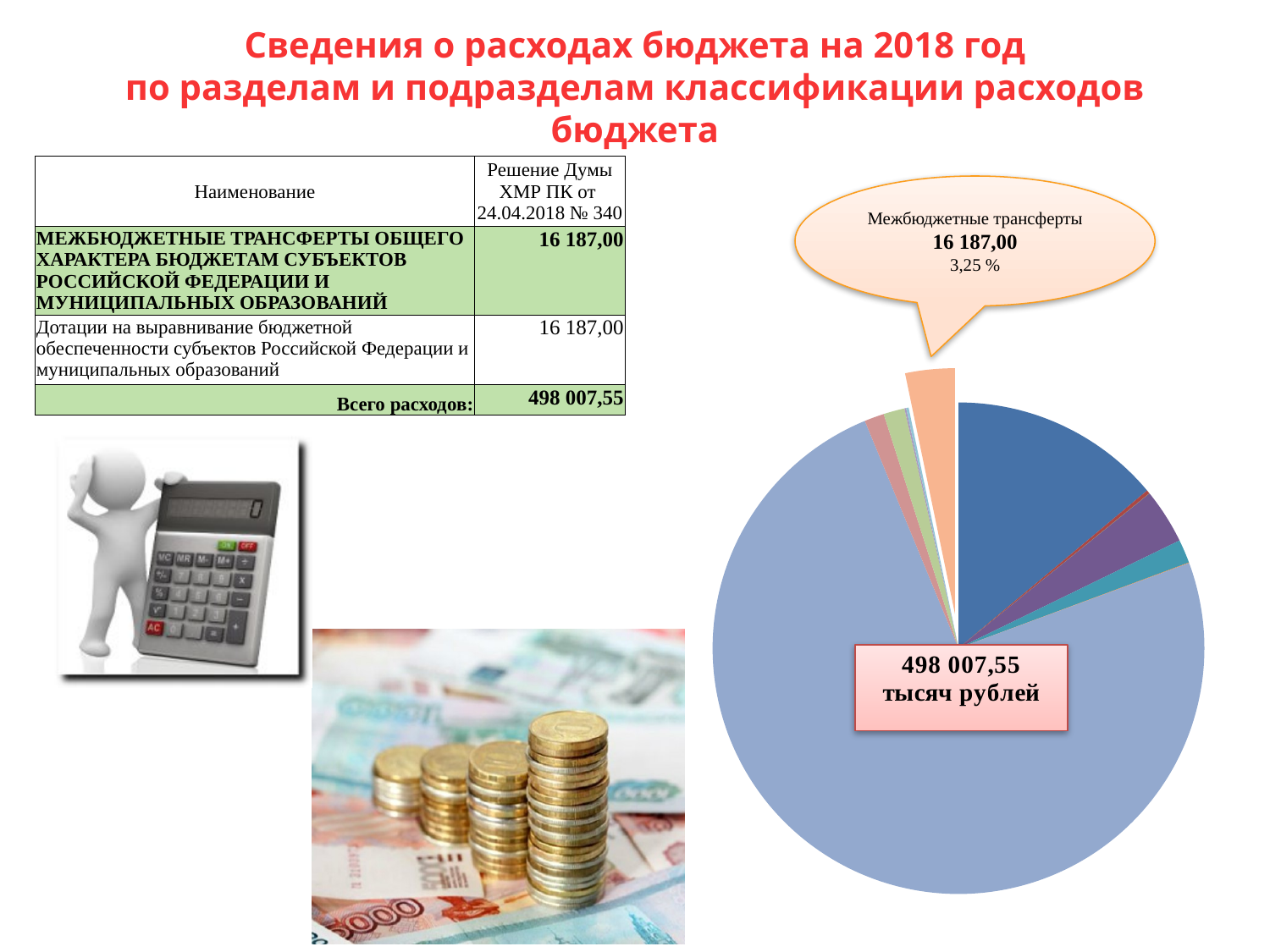
Is the share of the Межбюджетные трансферты slice greater or less than 50%? less In the pie chart, what share of the total does the Межбюджетные трансферты slice represent? 3,25 % Which slice of the pie chart is pulled out (exploded) from the rest of the pie? Межбюджетные трансферты In the pie chart, what value is shown for the slice labelled Межбюджетные трансферты? 16 187,00 Does the pie chart have a legend listing its categories? No What total value is shown in the centre label of the pie chart? 498 007,55 тысяч рублей Is the Межбюджетные трансферты slice the largest slice of the pie chart? No What kind of chart is shown on the right side of the slide? Pie chart